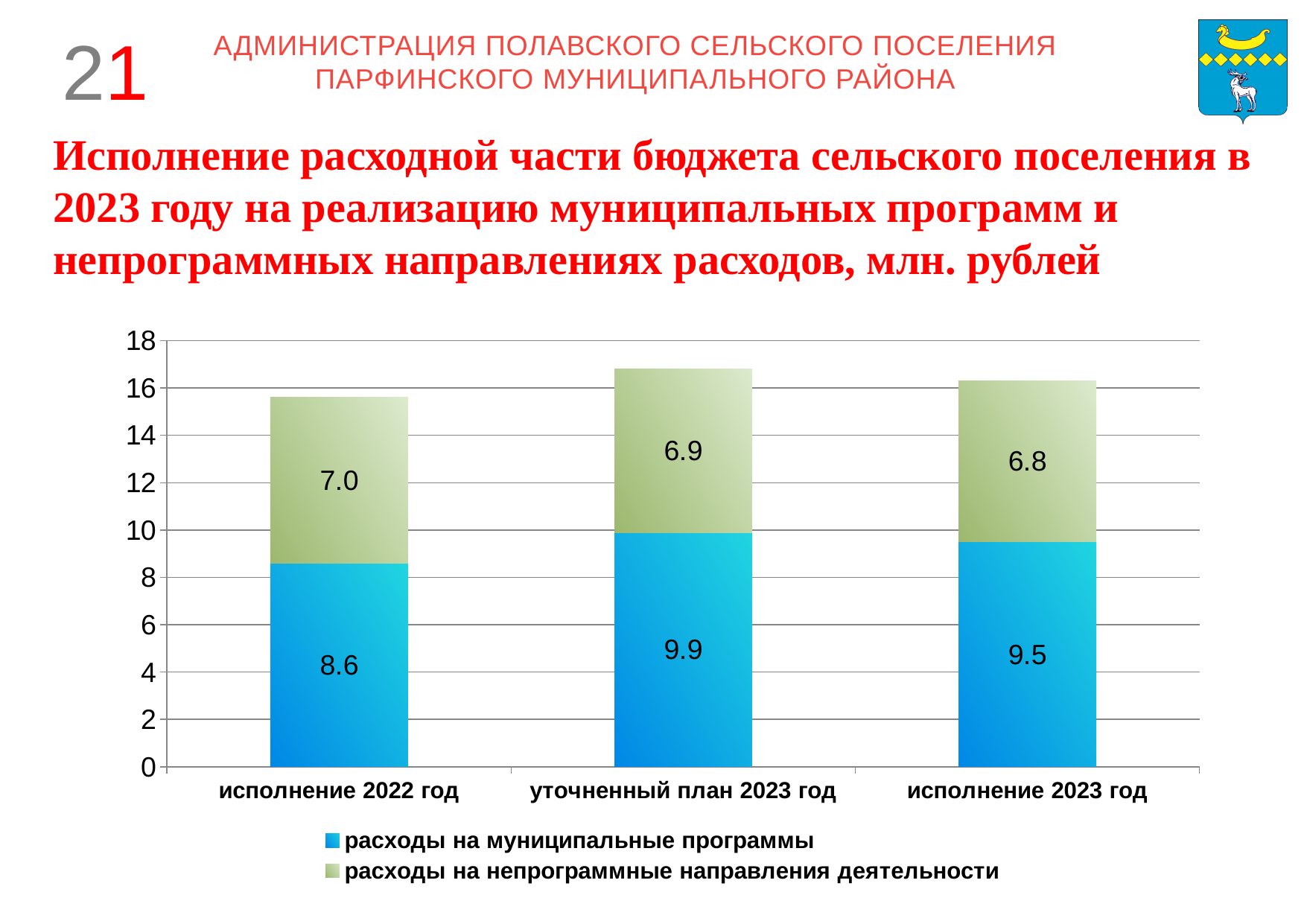
What is the total of the stacked bar for 'исполнение 2022 год'? 15.6 What is the value of 'расходы на муниципальные программы' for 'исполнение 2023 год'? 9.5 Which category has the highest value for 'расходы на муниципальные программы'? уточненный план 2023 год How many categories are shown on the x axis? 3 What is the value of 'расходы на непрограммные направления деятельности' for 'уточненный план 2023 год'? 6.9 Which category has the lowest value for 'расходы на непрограммные направления деятельности'? исполнение 2023 год What is the total of the stacked bar for 'исполнение 2023 год'? 16.3 How many series does the legend list? 2 What is the difference between 'расходы на муниципальные программы' for 'уточненный план 2023 год' and for 'исполнение 2023 год'? 0.4 What kind of chart is shown on the slide? stacked bar chart Which is larger: 'расходы на муниципальные программы' for 'исполнение 2022 год' or for 'исполнение 2023 год'? исполнение 2023 год What is the value of 'расходы на муниципальные программы' for 'исполнение 2022 год'? 8.6